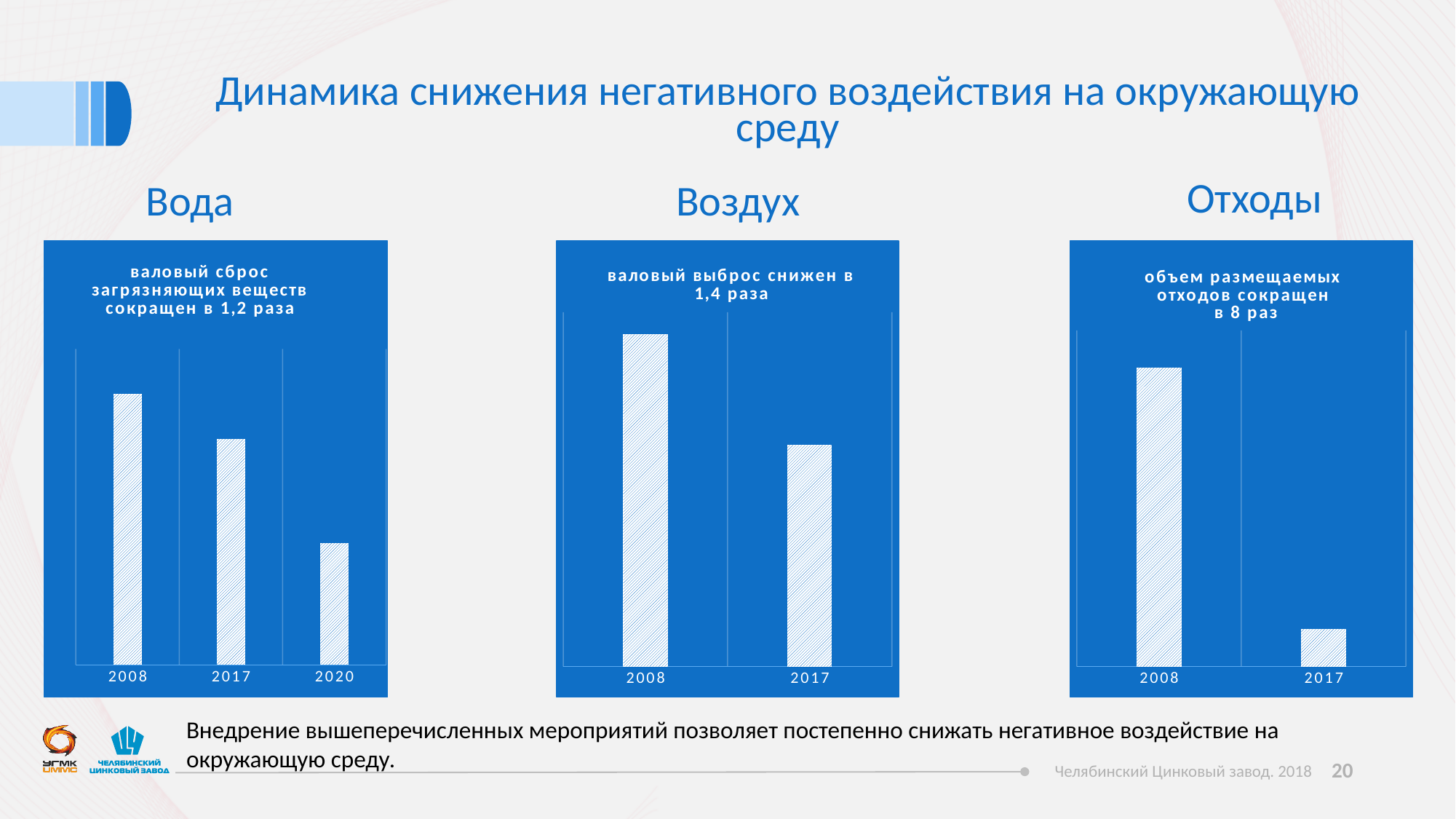
How many categories (years) are shown on the x axis of the "Вода" chart? 3 In the "Отходы" chart, which year has the lowest bar? 2017 According to the text inside the "Воздух" chart, by what factor was the gross emission reduced? в 1,4 раза In the "Вода" chart, do the bars rise or fall from 2008 to 2020? fall In the "Отходы" chart, do the values rise or fall from 2008 to 2017? fall According to the text inside the "Отходы" chart, by what factor was the volume of disposed waste reduced? в 8 раз What type of chart is shown under the heading "Вода"? bar chart In the "Вода" chart, which year has the highest bar? 2008 How many bars are shown in the "Воздух" chart? 2 How many categories are shown on the x axis of the "Отходы" chart? 2 In the "Воздух" chart, which year has the larger bar, 2008 or 2017? 2008 In the "Вода" chart, which year has the lowest bar? 2020